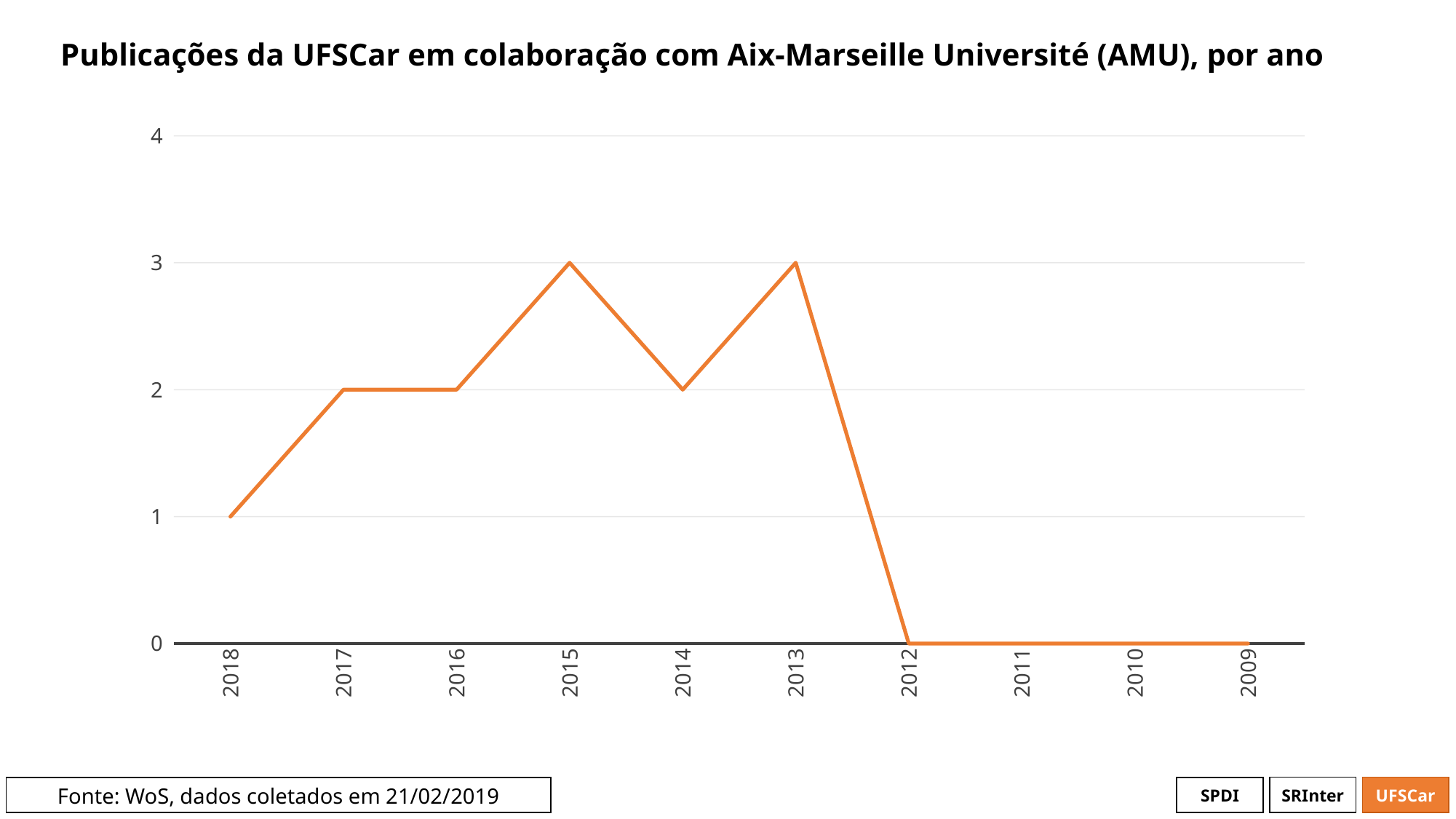
Which year has the larger value, 2017 or 2018? 2017 Moving from 2013 to 2012 along the x axis, does the line rise or fall? fall What is the value for 2018? 1 Which year has the larger value, 2015 or 2014? 2015 What is the first year shown on the left of the x axis? 2018 What kind of chart is shown on the slide? line chart What is the value for 2015? 3 How many years are plotted on the x axis? 10 What is the value for 2012? 0 What is the value for 2014? 2 What is the difference between the values for 2015 and 2018? 2 What is the highest value reached by the line? 3